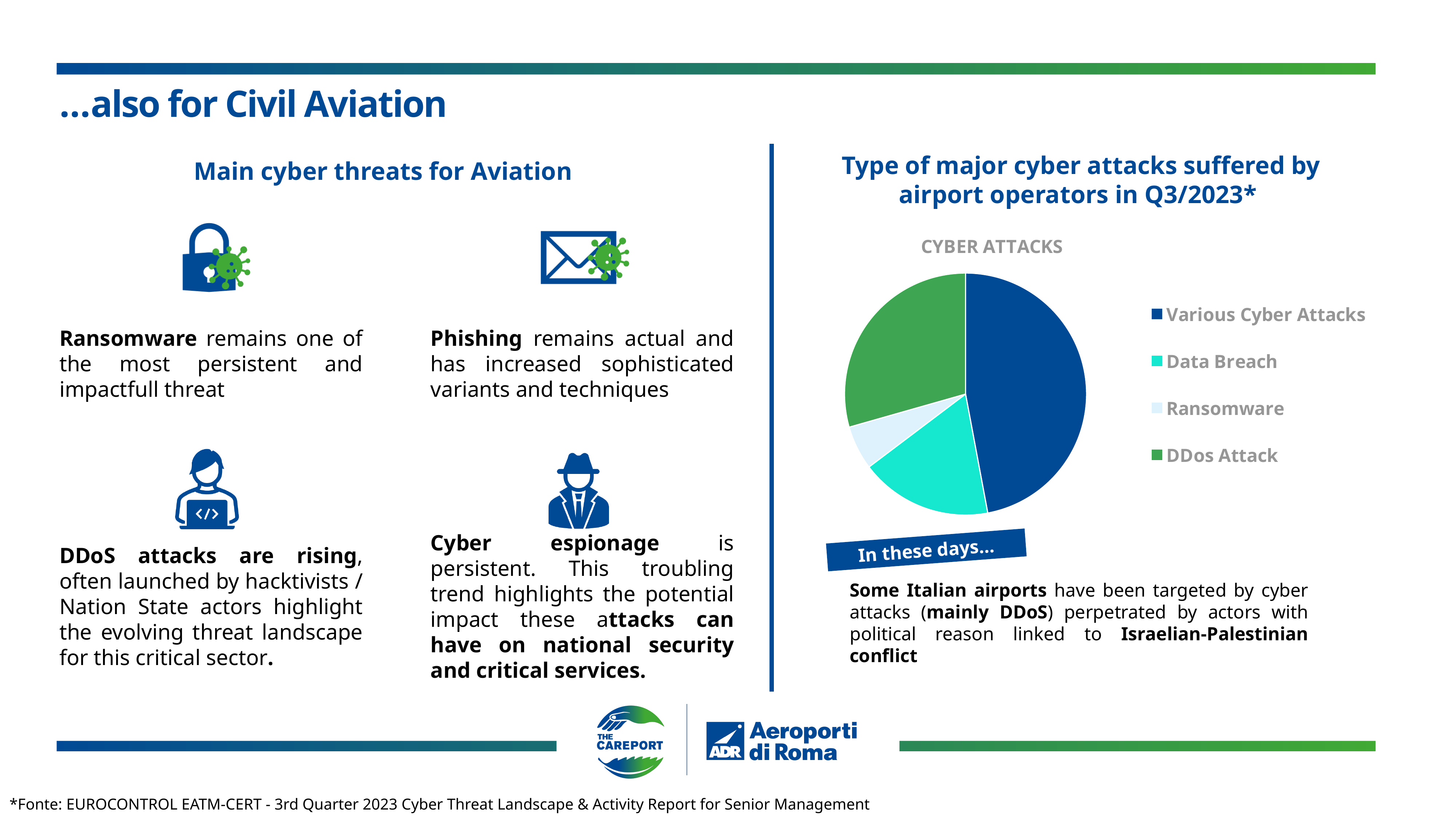
Which category has the smallest slice in the "CYBER ATTACKS" pie chart? Ransomware What colour is the DDos Attack slice in the "CYBER ATTACKS" pie chart? Green How many slices does the "CYBER ATTACKS" pie chart have? 4 What kind of chart is shown under the heading "CYBER ATTACKS"? Pie chart In the "CYBER ATTACKS" pie chart, which slice is larger: Data Breach or Ransomware? Data Breach What is the title printed above the pie chart? CYBER ATTACKS Which category is the second largest slice in the "CYBER ATTACKS" pie chart? DDos Attack How many entries does the legend of the "CYBER ATTACKS" pie chart list? 4 In the "CYBER ATTACKS" pie chart, which slice is larger: DDos Attack or Data Breach? DDos Attack In the "CYBER ATTACKS" pie chart, which slice is larger: Various Cyber Attacks or DDos Attack? Various Cyber Attacks Which category has the largest slice in the "CYBER ATTACKS" pie chart? Various Cyber Attacks